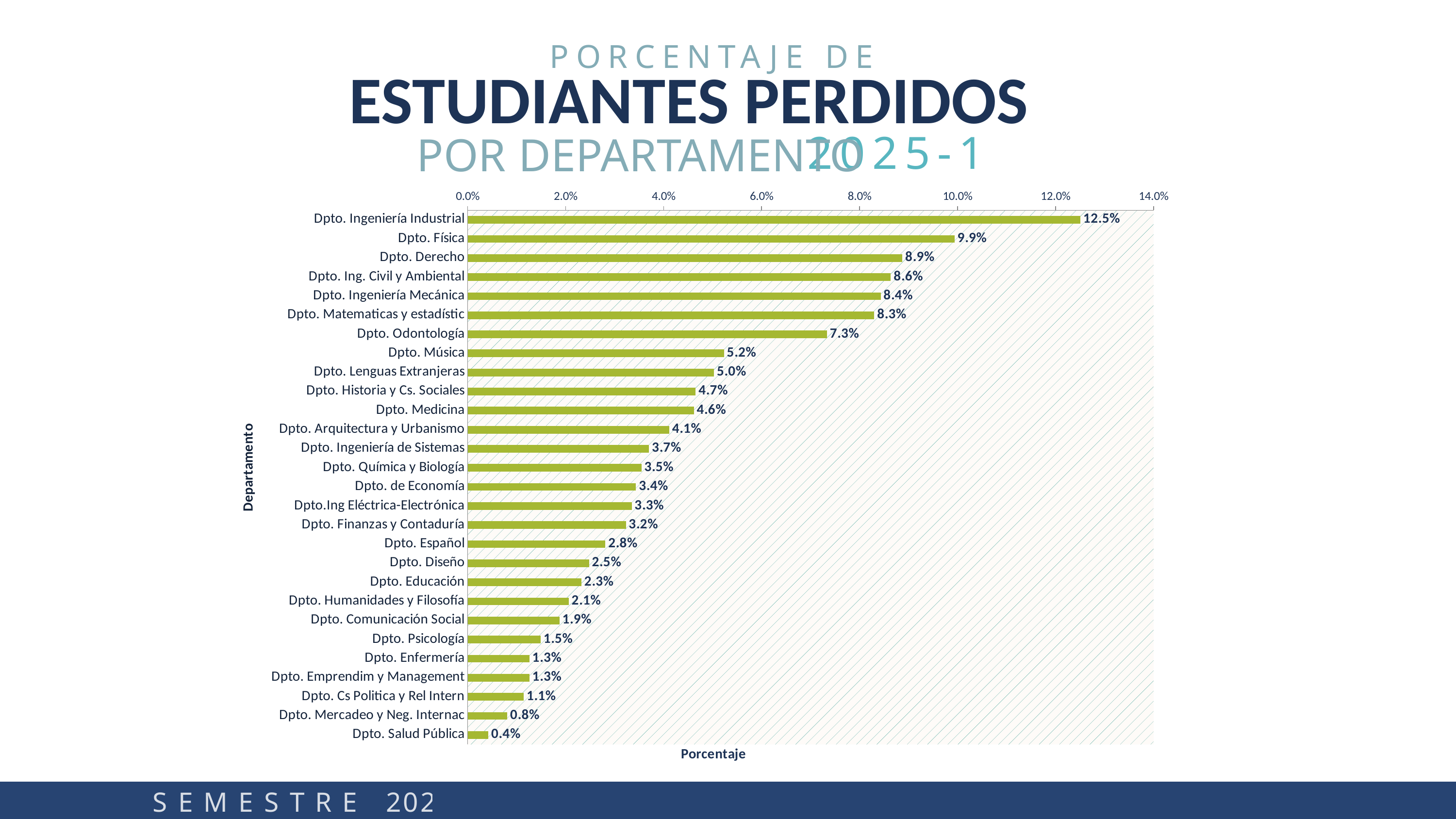
Which department has the highest percentage? Dpto. Ingeniería Industrial What is the value for Dpto. Ingeniería Industrial? 12.5% What is the value for Dpto. Odontología? 7.3% Is the value for Dpto. Ing. Civil y Ambiental greater or less than 8.0%? greater What is the value for Dpto. Medicina? 4.6% How many departments are shown in the chart? 28 Which is larger, the value for Dpto. Música or the value for Dpto. Lenguas Extranjeras? Dpto. Música Which department has the lowest percentage? Dpto. Salud Pública What is the label of the horizontal axis? Porcentaje What is the value for Dpto. Psicología? 1.5% What kind of chart is shown on the slide? bar chart What is the difference between the values for Dpto. Física and Dpto. Derecho? 1.0%